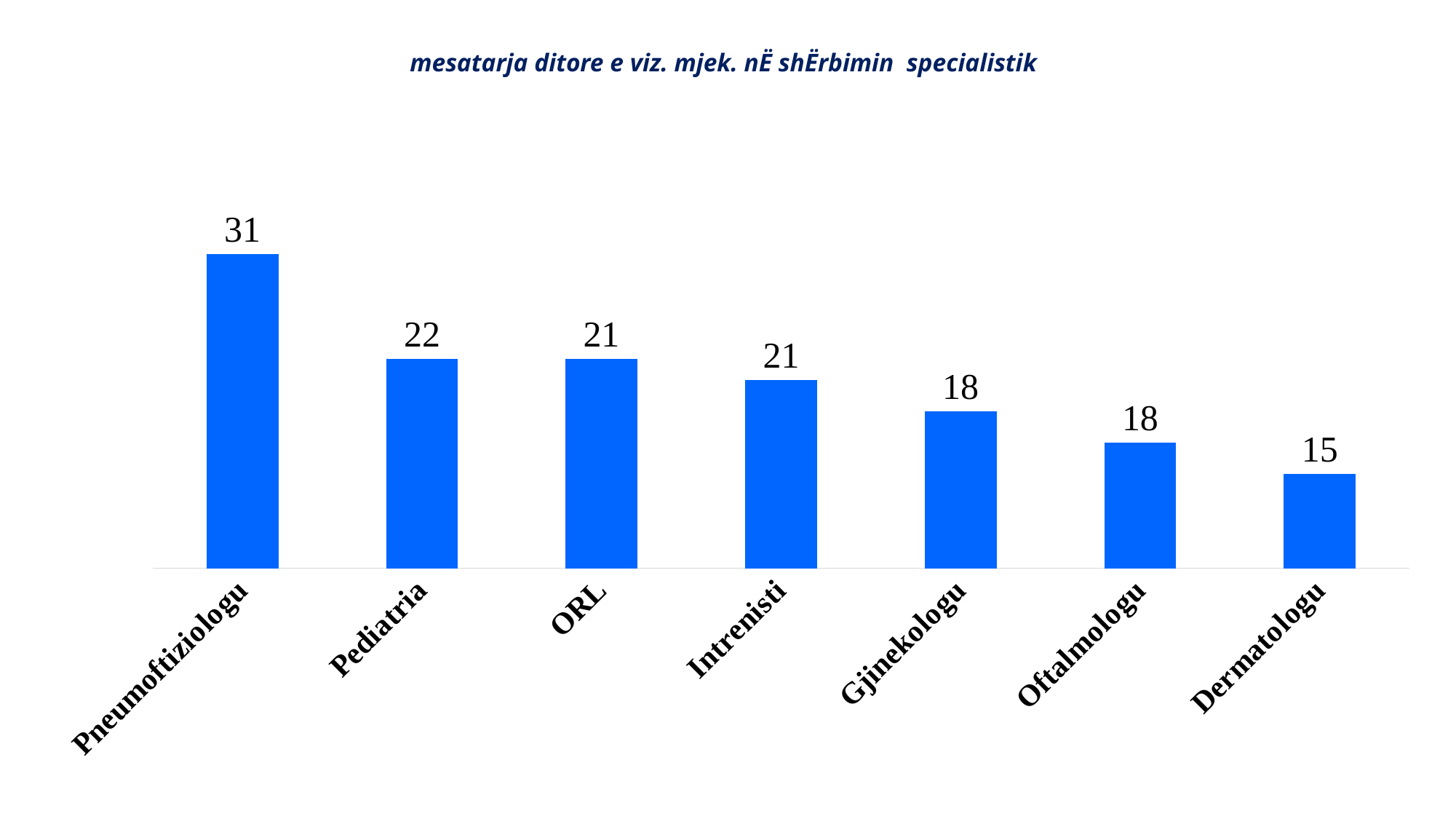
How many categories are shown in the chart? 7 What is the difference between the values for ORL and Dermatologu? 6 Which category has the lowest value? Dermatologu What is the difference between the values for Pneumoftiziologu and Pediatria? 9 What kind of chart is shown on the slide? Bar chart What is the value for Dermatologu? 15 What is the value for Gjinekologu? 18 Which is larger, the value for Pediatria or the value for Oftalmologu? Pediatria Do the values rise or fall from left to right along the x axis? Fall What is the value for Pneumoftiziologu? 31 Which category has the highest value? Pneumoftiziologu What is the value for Pediatria? 22